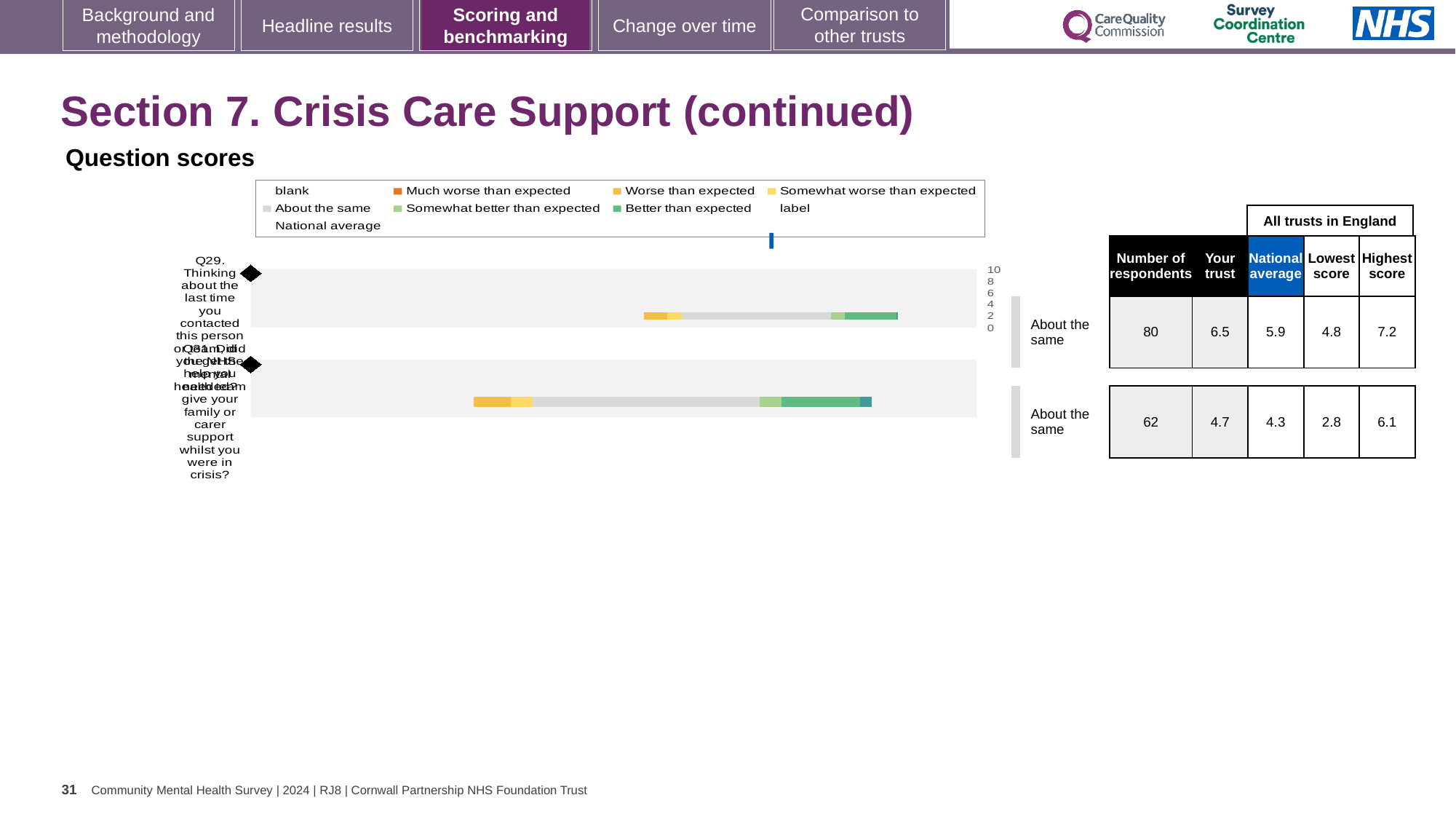
Which question has the higher 'Your trust' score, Q29 or Q31? Q29 What is the difference between the highest and lowest scores for Q31? 3.3 What is the national average score for Q31? 4.3 By how much does the 'Your trust' score for Q29 exceed the national average for Q29? 0.6 What colour does the legend use for 'Better than expected'? green What benchmark category is shown for Q31? About the same What is the 'Your trust' score for Q29? 6.5 How many respondents answered Q29? 80 What is the lowest score among all trusts in England for Q29? 4.8 What kind of chart is used to show the question scores? bar chart How many questions are plotted in the question scores chart? 2 What is the highest score among all trusts in England for Q31? 6.1